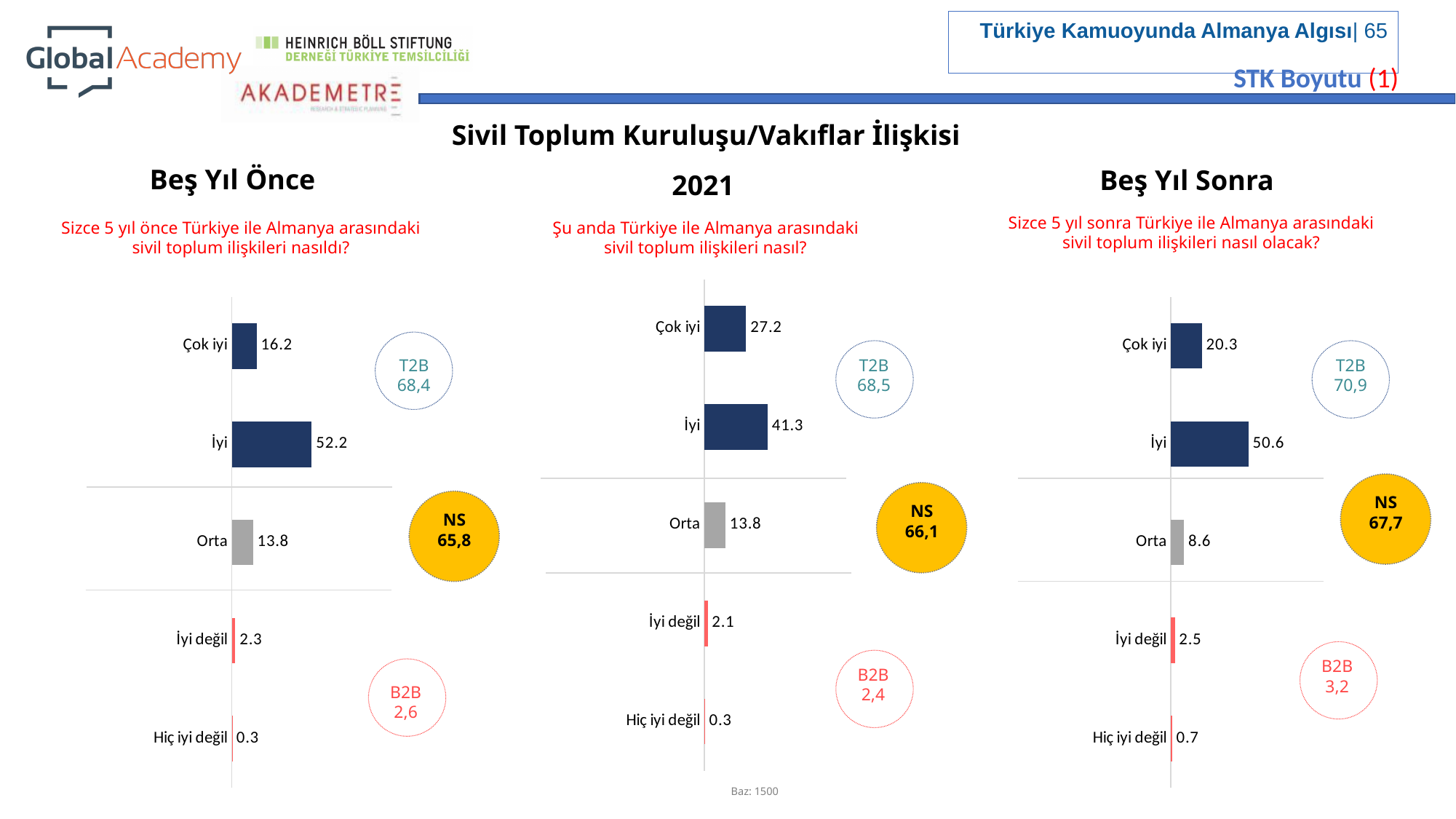
In the 'Beş Yıl Sonra' chart, which category has the highest value? İyi In the 'Beş Yıl Önce' chart, what is the value for İyi? 52.2 In the '2021' chart, what is the value for Çok iyi? 27.2 Which is larger: Çok iyi in the '2021' chart or Çok iyi in the 'Beş Yıl Sonra' chart? 2021 In the 'Beş Yıl Sonra' chart, what is the value for Orta? 8.6 In the 'Beş Yıl Önce' chart, what is the difference between İyi and Çok iyi? 36.0 What is the T2B value shown next to the 'Beş Yıl Sonra' chart? 70,9 In the 'Beş Yıl Sonra' chart, what is the value for İyi değil? 2.5 In the '2021' chart, which category has the lowest value? Hiç iyi değil In the '2021' chart, what is the difference between İyi and Orta? 27.5 What kind of chart is the '2021' chart? bar chart How many categories does the 'Beş Yıl Önce' chart show? 5